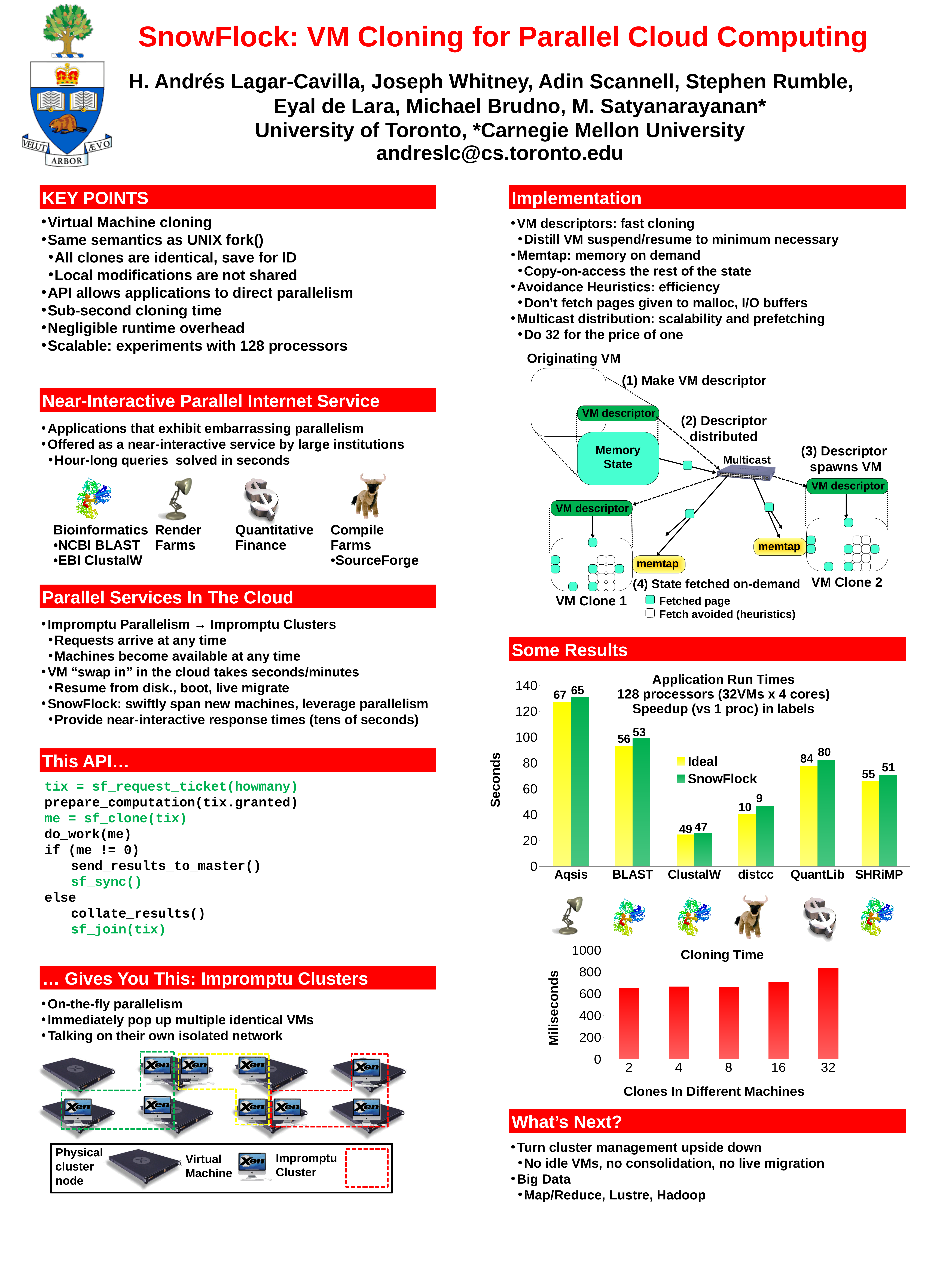
In the 'Cloning Time' chart, how many clone counts are shown on the x axis? 5 In the 'Application Run Times' chart, which application has the shortest run time? ClustalW In the 'Application Run Times' chart, which application has the longest run time? Aqsis What type of chart is the 'Application Run Times' chart? bar chart How many applications are shown on the x axis of the 'Application Run Times' chart? 6 In the 'Application Run Times' chart, what speedup label is printed above the Ideal bar for BLAST? 56 How many series does the legend of the 'Application Run Times' chart list? 2 In the 'Application Run Times' chart, is the Ideal run time for ClustalW greater or less than 40 seconds? less What type of chart is the 'Cloning Time' chart? bar chart In the 'Cloning Time' chart, which number of clones has the highest cloning time? 32 In the 'Application Run Times' chart, what speedup label is printed above the SnowFlock bar for QuantLib? 80 In the 'Application Run Times' chart, is the SnowFlock run time for Aqsis greater or less than 120 seconds? greater